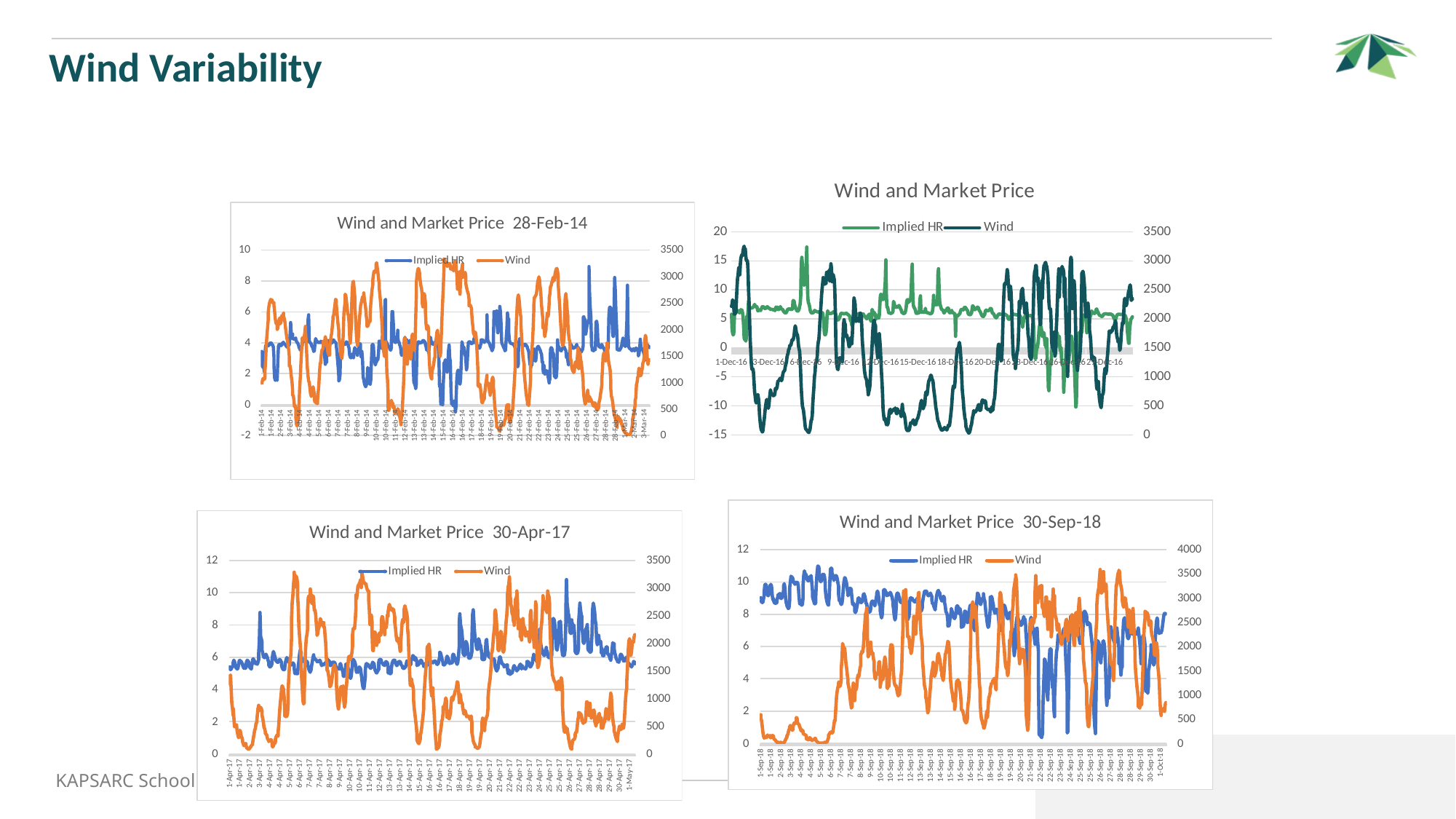
What is the title of the top-right chart on the slide? Wind and Market Price In the 'Wind and Market Price 30-Sep-18' chart, does the Implied HR series generally rise or fall from the start to the end of September? fall What kind of chart is 'Wind and Market Price 28-Feb-14'? Line chart What kind of chart is the top-right 'Wind and Market Price' chart? Line chart How many series does the legend of the 'Wind and Market Price 30-Sep-18' chart list? 2 In the 'Wind and Market Price 30-Apr-17' chart, which series is drawn in orange? Wind In the 'Wind and Market Price 30-Apr-17' chart, is the Implied HR value at 1-Apr-17 greater or less than 10? less In the 'Wind and Market Price 30-Sep-18' chart, is the Implied HR value at 1-Sep-18 greater or less than 6? greater